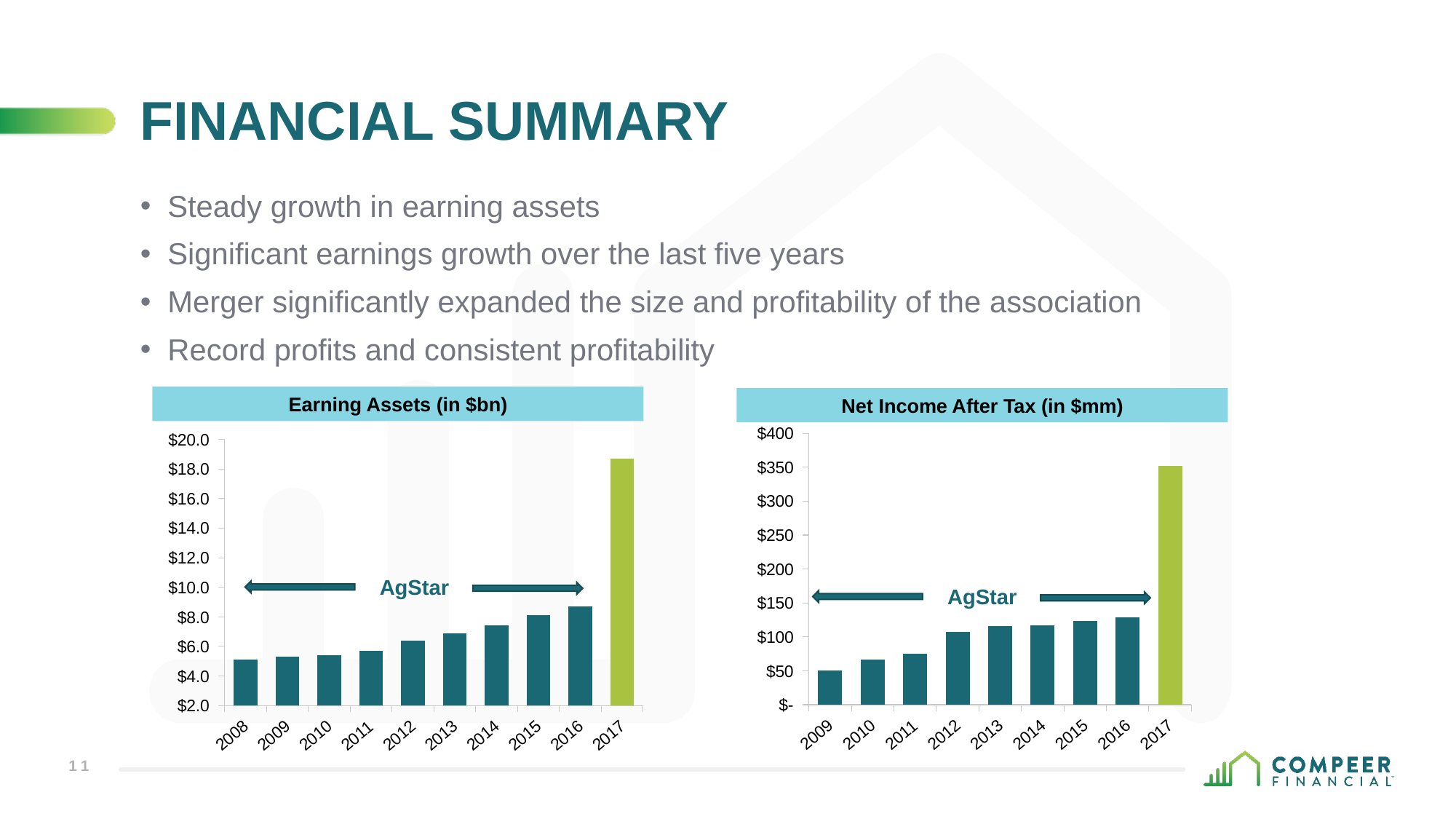
In the Earning Assets (in $bn) chart, which year has the highest value? 2017 In the Earning Assets (in $bn) chart, is the value for 2017 greater or less than $16.0? greater In the Net Income After Tax (in $mm) chart, which year has the lowest value? 2009 In the Net Income After Tax (in $mm) chart, which is larger, the value for 2016 or the value for 2009? 2016 What kind of chart is the Earning Assets (in $bn) chart? bar chart In the Earning Assets (in $bn) chart, do the values generally rise or fall from 2008 to 2017? rise In the Earning Assets (in $bn) chart, which year has the lowest value? 2008 How many years are shown on the x axis of the Net Income After Tax (in $mm) chart? 9 In the Net Income After Tax (in $mm) chart, which year has the highest value? 2017 In the Net Income After Tax (in $mm) chart, is the value for 2017 greater or less than $300? greater In the Earning Assets (in $bn) chart, is the value for 2014 greater or less than $8.0? less How many years are shown on the x axis of the Earning Assets (in $bn) chart? 10